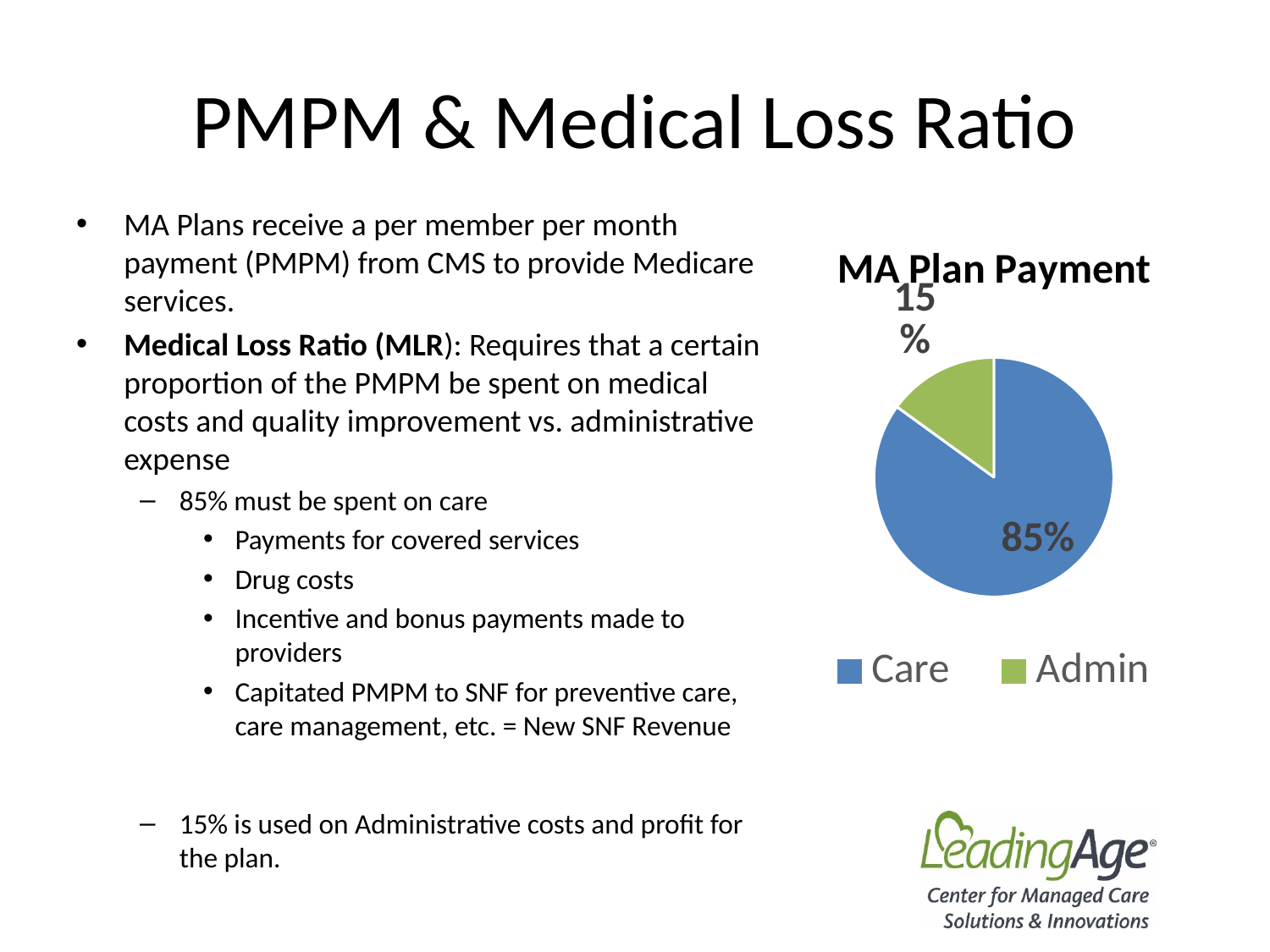
What is the title of the chart? MA Plan Payment What share of the MA Plan Payment pie is Care? 85% How many entries does the legend list? 2 What is the difference between the Care share and the Admin share? 70% How many slices does the pie chart have? 2 What type of chart is shown on the slide? pie chart Which slice of the pie is the largest? Care Which slice of the pie is the smallest? Admin What colour is the Admin slice in the pie chart? green Which is larger, the Care slice or the Admin slice? Care What share of the MA Plan Payment pie is Admin? 15%